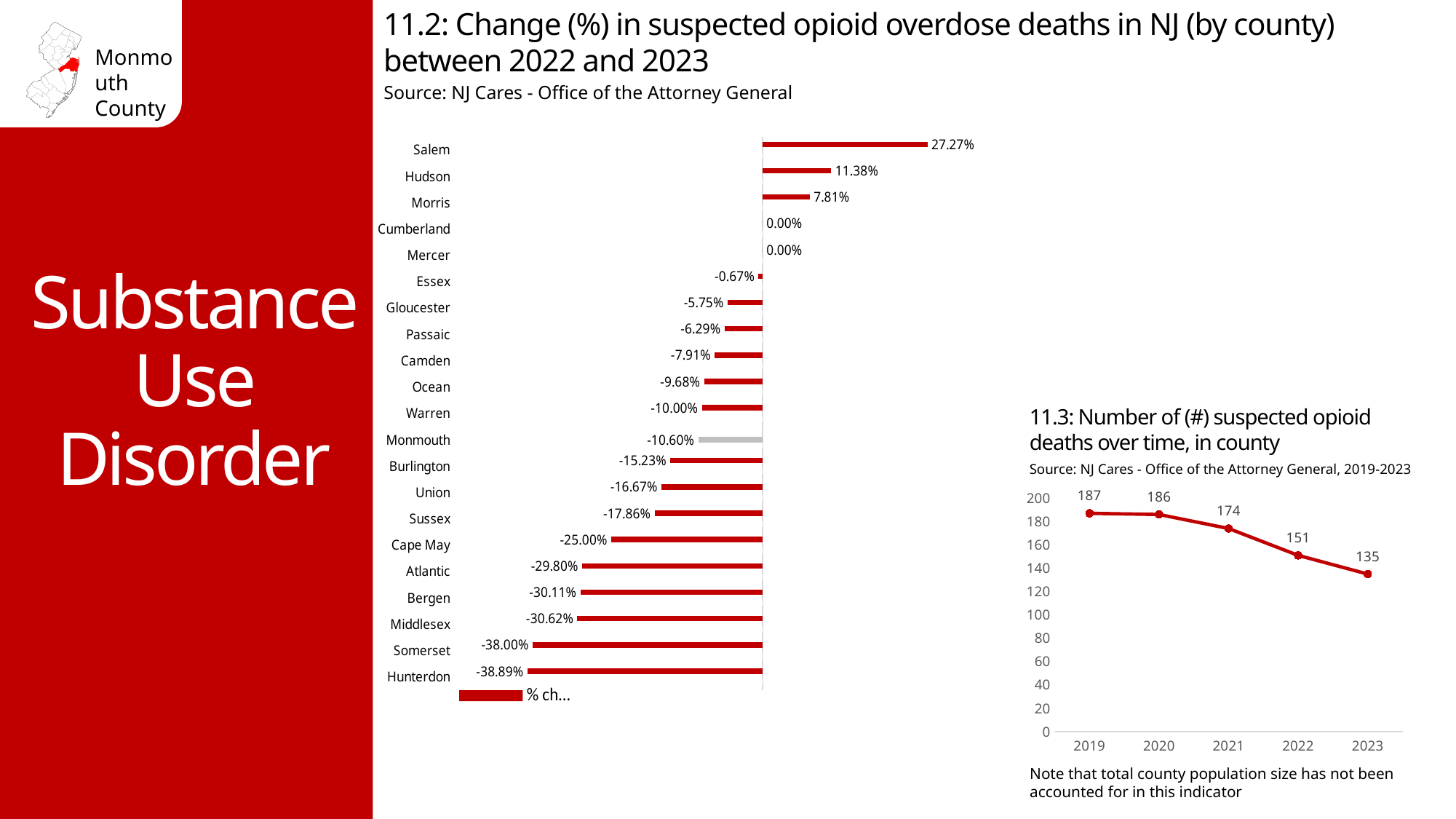
What kind of chart is '11.3: Number of (#) suspected opioid deaths over time, in county'? Line chart In the chart '11.2: Change (%) in suspected opioid overdose deaths in NJ (by county) between 2022 and 2023', which is larger, the value for Bergen or the value for Cape May? Cape May In the chart '11.2: Change (%) in suspected opioid overdose deaths in NJ (by county) between 2022 and 2023', which county has the highest value? Salem In the chart '11.3: Number of (#) suspected opioid deaths over time, in county', do the values rise or fall from 2019 to 2023? Fall What kind of chart is '11.2: Change (%) in suspected opioid overdose deaths in NJ (by county) between 2022 and 2023'? Bar chart In the chart '11.2: Change (%) in suspected opioid overdose deaths in NJ (by county) between 2022 and 2023', which county has the lowest value? Hunterdon In the chart '11.2: Change (%) in suspected opioid overdose deaths in NJ (by county) between 2022 and 2023', what is the value for Hudson? 11.38% In the chart '11.3: Number of (#) suspected opioid deaths over time, in county', how many years are plotted? 5 In the chart '11.3: Number of (#) suspected opioid deaths over time, in county', what is the difference between the 2019 value and the 2023 value? 52 In the chart '11.2: Change (%) in suspected opioid overdose deaths in NJ (by county) between 2022 and 2023', what is the value for Monmouth? -10.60% In the chart '11.3: Number of (#) suspected opioid deaths over time, in county', what is the value for 2021? 174 In the chart '11.2: Change (%) in suspected opioid overdose deaths in NJ (by county) between 2022 and 2023', how many counties are shown? 21